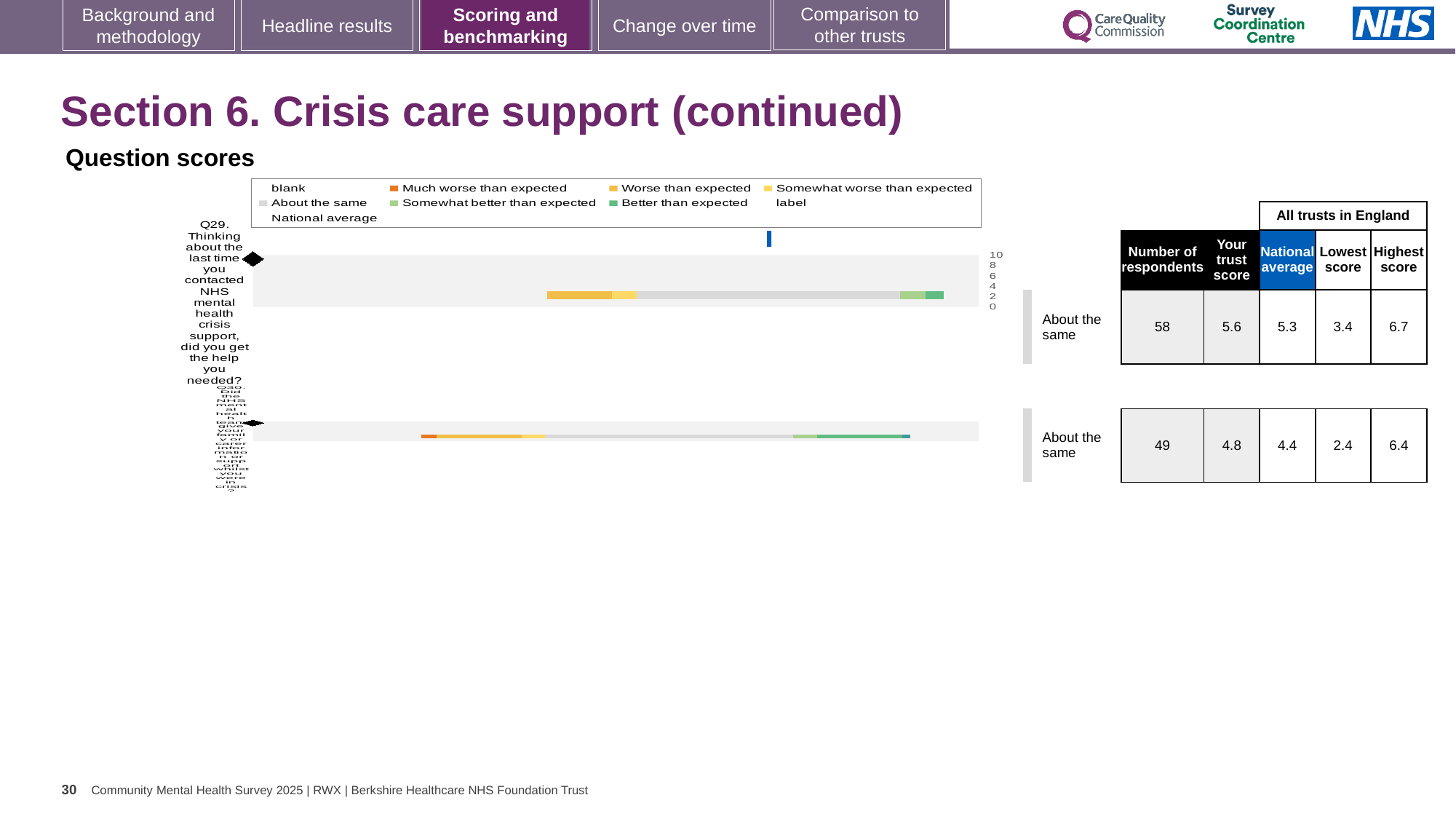
What is the benchmark category shown for Q29? About the same What is the number of respondents for Q29? 58 Which legend entry is shown in orange? Much worse than expected What is the highest score among all trusts in England for Q29? 6.7 What is the trust score for Q29? 5.6 How many questions (bars) are plotted in the chart? 2 Which is larger for Q29, the trust score or the national average? trust score How many entries does the chart legend list? 9 What kind of chart is shown under 'Question scores'? bar chart What is the difference between the trust score and the national average for Q30? 0.4 What is the national average for Q30? 4.4 What is the lowest score among all trusts in England for Q30? 2.4